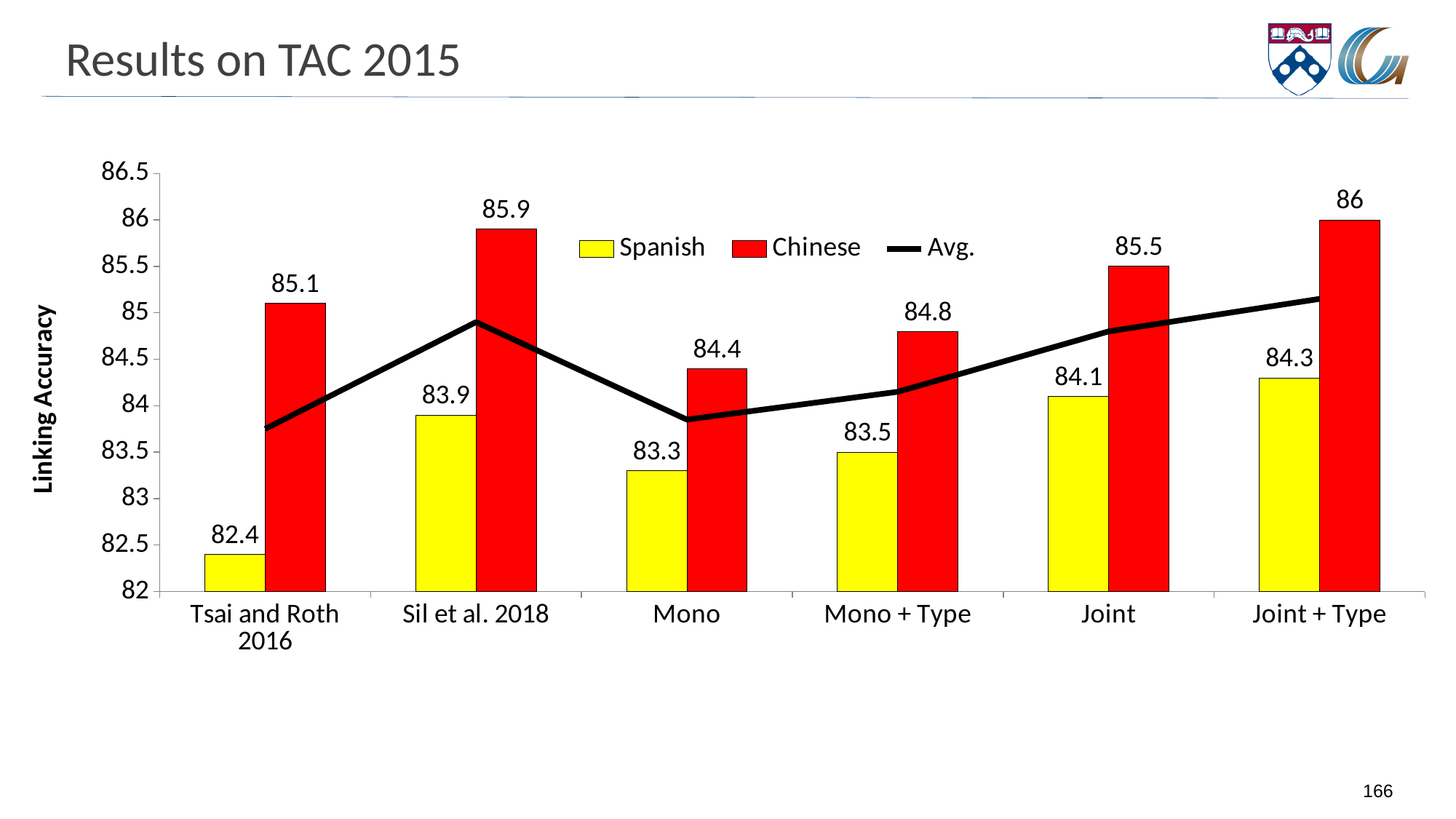
What is the difference between the Chinese and Spanish linking accuracy for Mono? 1.1 How many series does the legend list? 3 Which category has the lowest Spanish linking accuracy? Tsai and Roth 2016 What is the label of the y axis? Linking Accuracy What is the Chinese linking accuracy for Joint + Type? 86 How many categories are shown on the x axis? 6 What is the Spanish linking accuracy for Tsai and Roth 2016? 82.4 What is the Chinese linking accuracy for Sil et al. 2018? 85.9 Which category has the highest Chinese linking accuracy? Joint + Type Is the Avg. value for Sil et al. 2018 greater or less than 84.5? greater Which is larger, the Spanish accuracy for Joint or the Spanish accuracy for Sil et al. 2018? Joint What is the Spanish linking accuracy for Mono + Type? 83.5